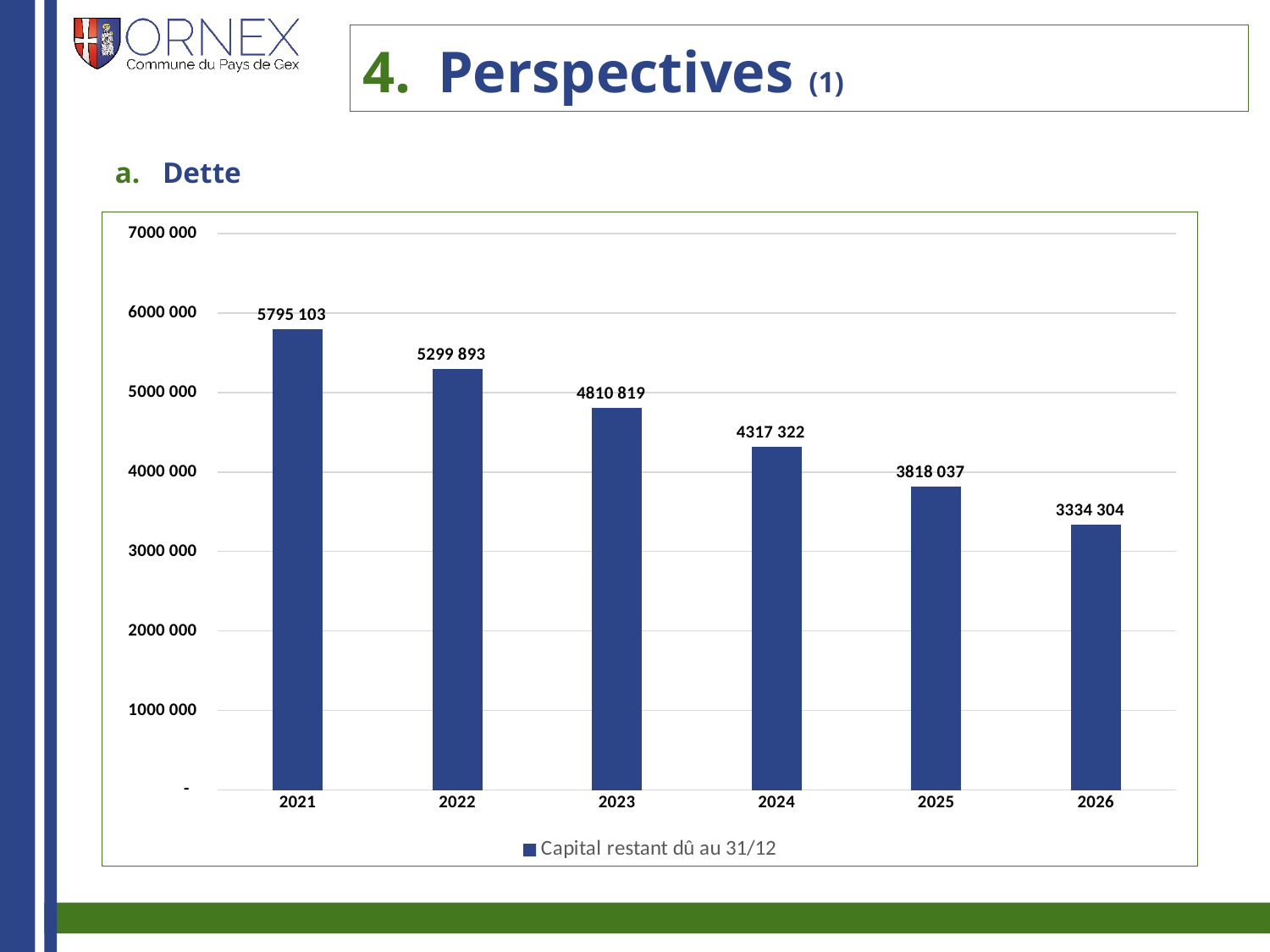
Do the values rise or fall from 2021 to 2026? fall What is the value for 2026? 3334 304 Which is larger, the value for 2023 or the value for 2025? 2023 Which year has the highest value? 2021 What is the difference between the values for 2021 and 2022? 495 210 What is the value for 2024? 4317 322 What is the value for 2021? 5795 103 What kind of chart is this? bar chart How many years are shown on the x axis? 6 What is the difference between the values for 2021 and 2026? 2460 799 Is the value for 2025 greater or less than 4000 000? less Which year has the lowest value? 2026